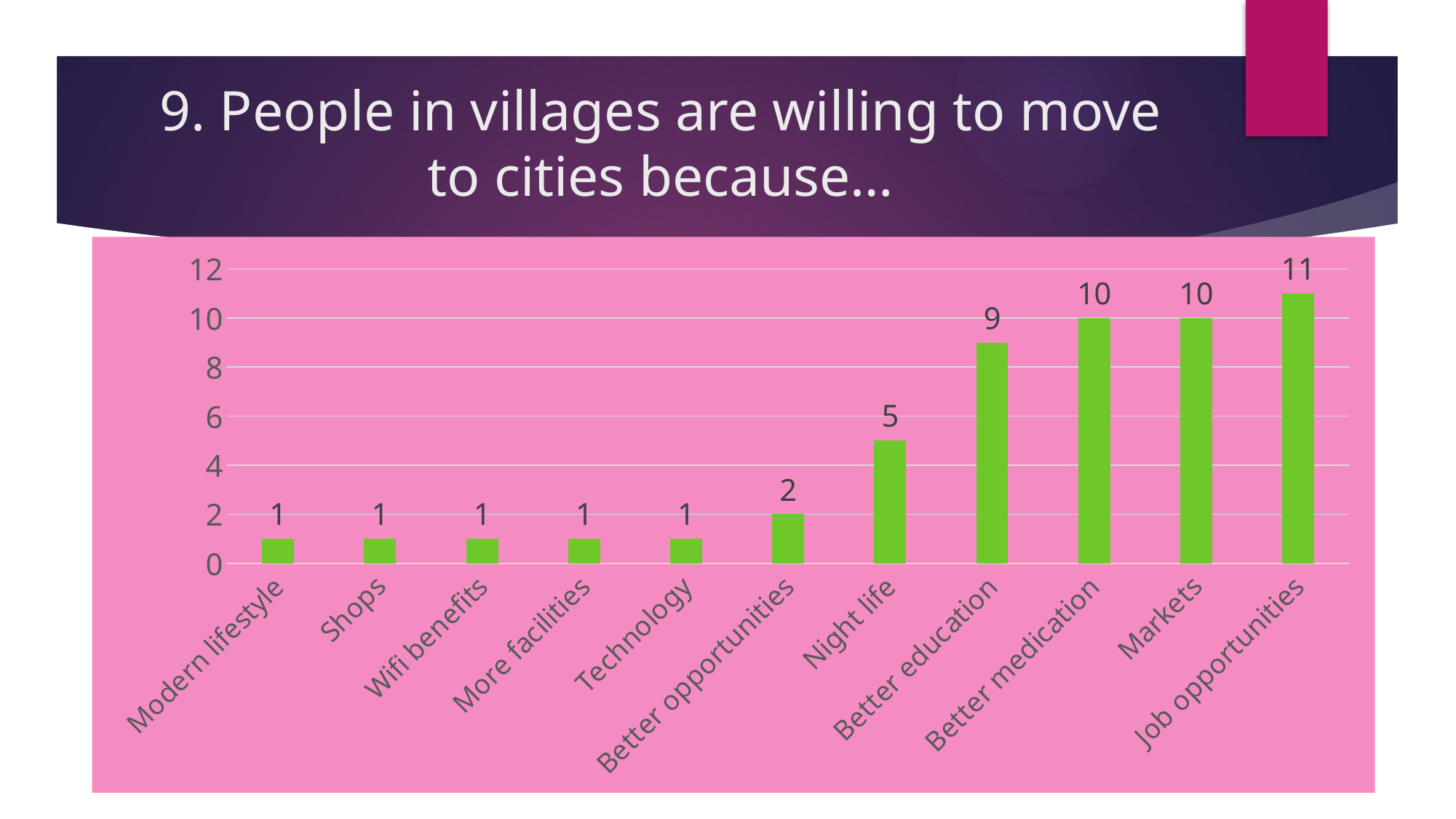
What is the difference between the values for Better medication and Better education? 1 What is the value for Better opportunities? 2 Do the values generally rise or fall from left to right along the x axis? rise What is the difference between the values for Job opportunities and Night life? 6 Which category has the highest value? Job opportunities Is the value for Better education greater or less than 8? greater Which is larger, the value for Night life or the value for Better opportunities? Night life What is the value for Night life? 5 What kind of chart is shown on the slide? bar chart What is the value for Job opportunities? 11 How many categories are shown on the x axis? 11 What is the value for Better education? 9